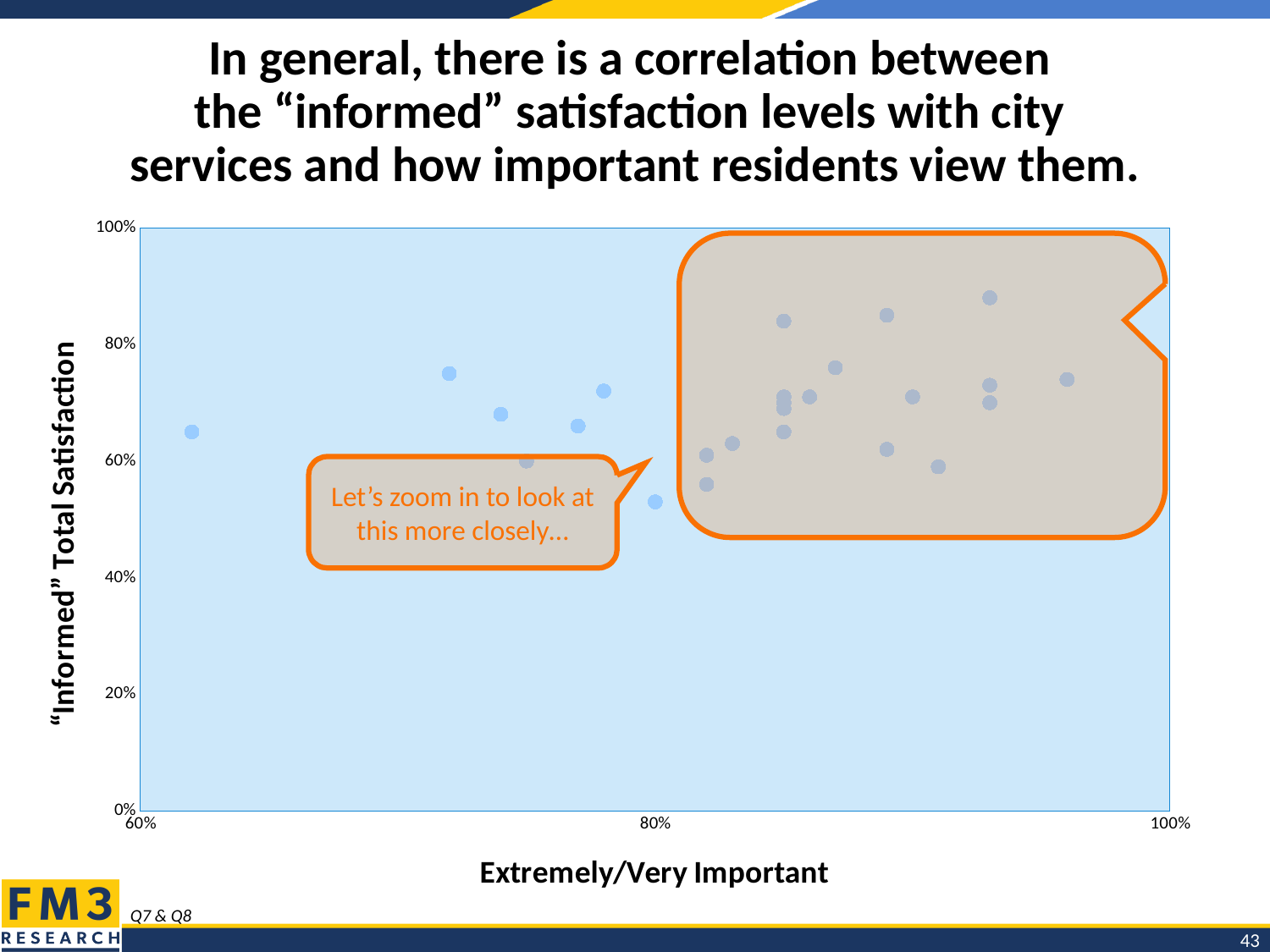
Is the satisfaction value of the lowest point greater or less than 60%? less What is the lowest value shown on the horizontal axis? 60% As importance increases along the horizontal axis, do the satisfaction values generally rise or fall? Rise What kind of chart is shown on the slide? Scatter chart What is the highest value shown on the vertical axis? 100% Is the satisfaction value of the leftmost point greater or less than 60%? greater What is the title of the chart's horizontal axis? Extremely/Very Important Is the satisfaction value of the highest point greater or less than 80%? greater What is the highest value shown on the horizontal axis? 100% What is the title of the chart's vertical axis? "Informed" Total Satisfaction